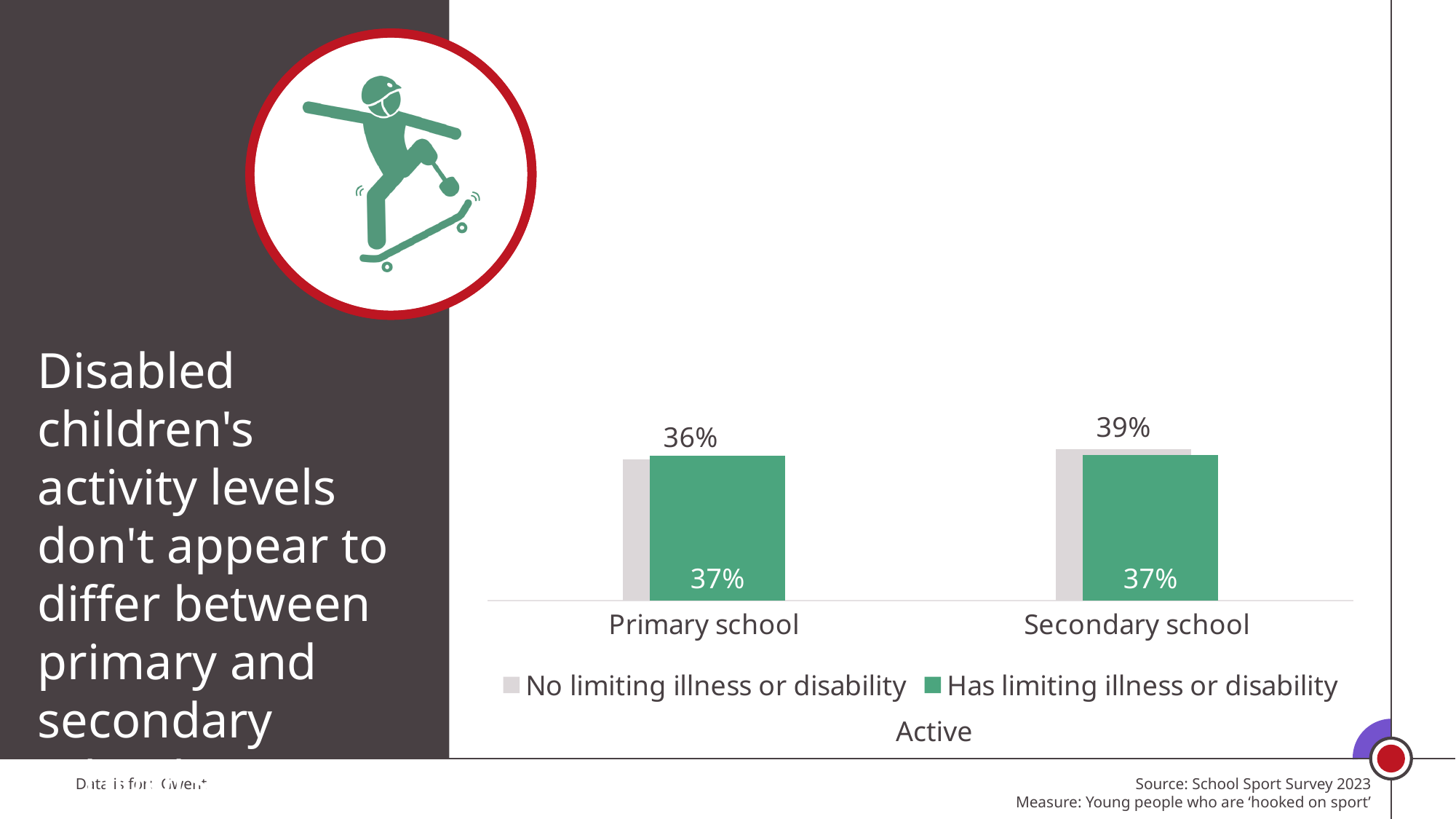
Which series has the higher value at Secondary school? No limiting illness or disability At Secondary school, what is the difference between the 'No limiting illness or disability' and 'Has limiting illness or disability' values? 2 percentage points What is the value for 'No limiting illness or disability' at Secondary school? 39% What kind of chart is shown on the slide? Bar chart What is the difference between the 'No limiting illness or disability' values for Secondary school and Primary school? 3 percentage points What is the value for 'Has limiting illness or disability' at Secondary school? 37% What is the value for 'No limiting illness or disability' at Primary school? 36% How many series does the legend list? 2 How many categories are shown on the x axis? 2 Which school stage has the higher value for 'No limiting illness or disability'? Secondary school What is the value for 'Has limiting illness or disability' at Primary school? 37%